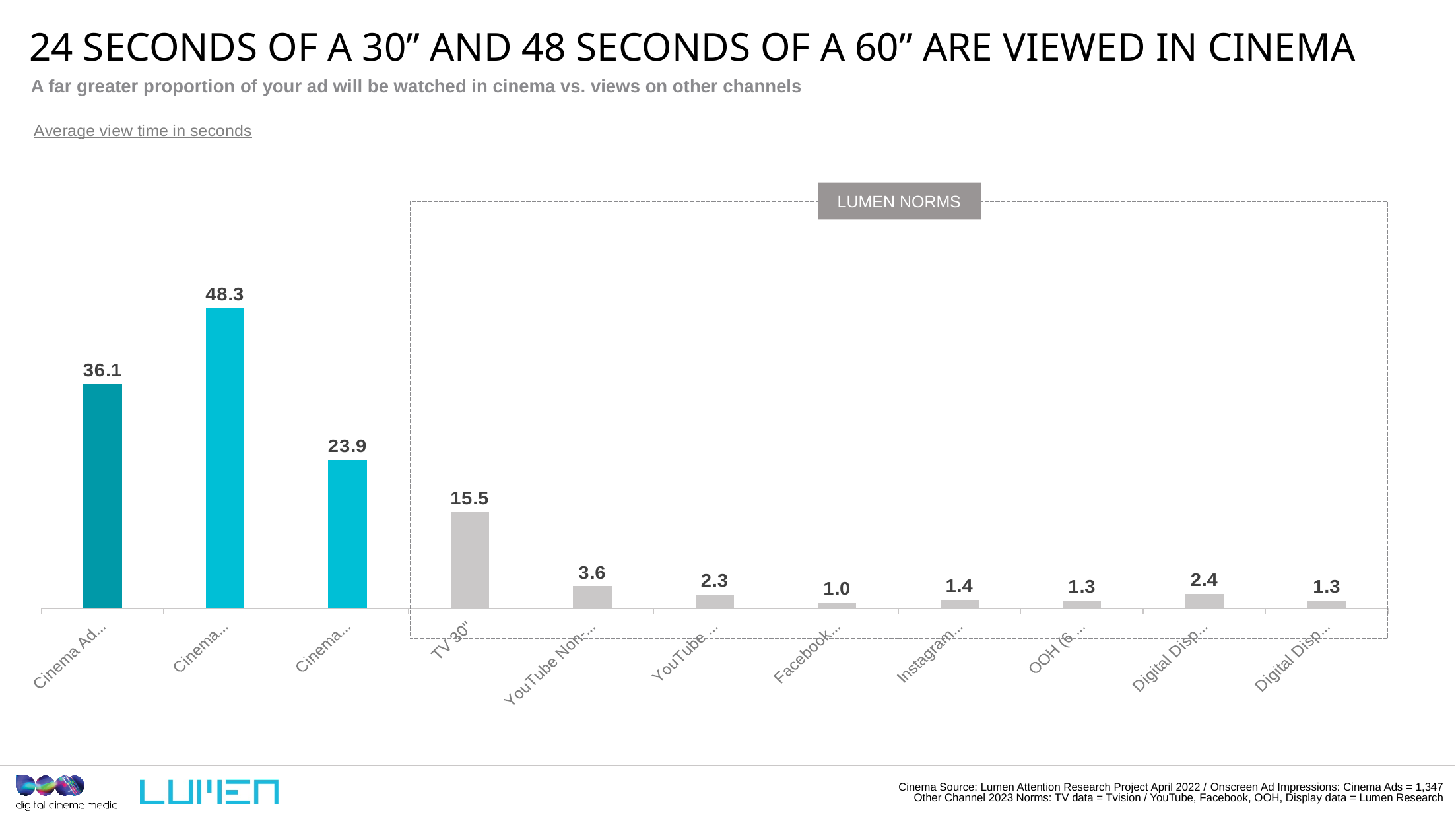
What type of chart is shown on the slide? Bar chart How many bars are plotted in the chart? 11 What is the average view time in seconds for TV 30"? 15.5 What is the difference between the first bar (36.1) and the third bar (23.9)? 12.2 What label appears on the dashed box enclosing the grey bars? LUMEN NORMS What is the highest value shown in the chart? 48.3 Which bar has the lowest value in the chart? Facebook Which is larger, the Instagram value or the Facebook value? Instagram What is the value of the first (leftmost) bar in the chart? 36.1 What is the difference between the TV 30" value and the Facebook value? 14.5 What value is shown for the Instagram bar? 1.4 What value is shown for the Facebook bar? 1.0